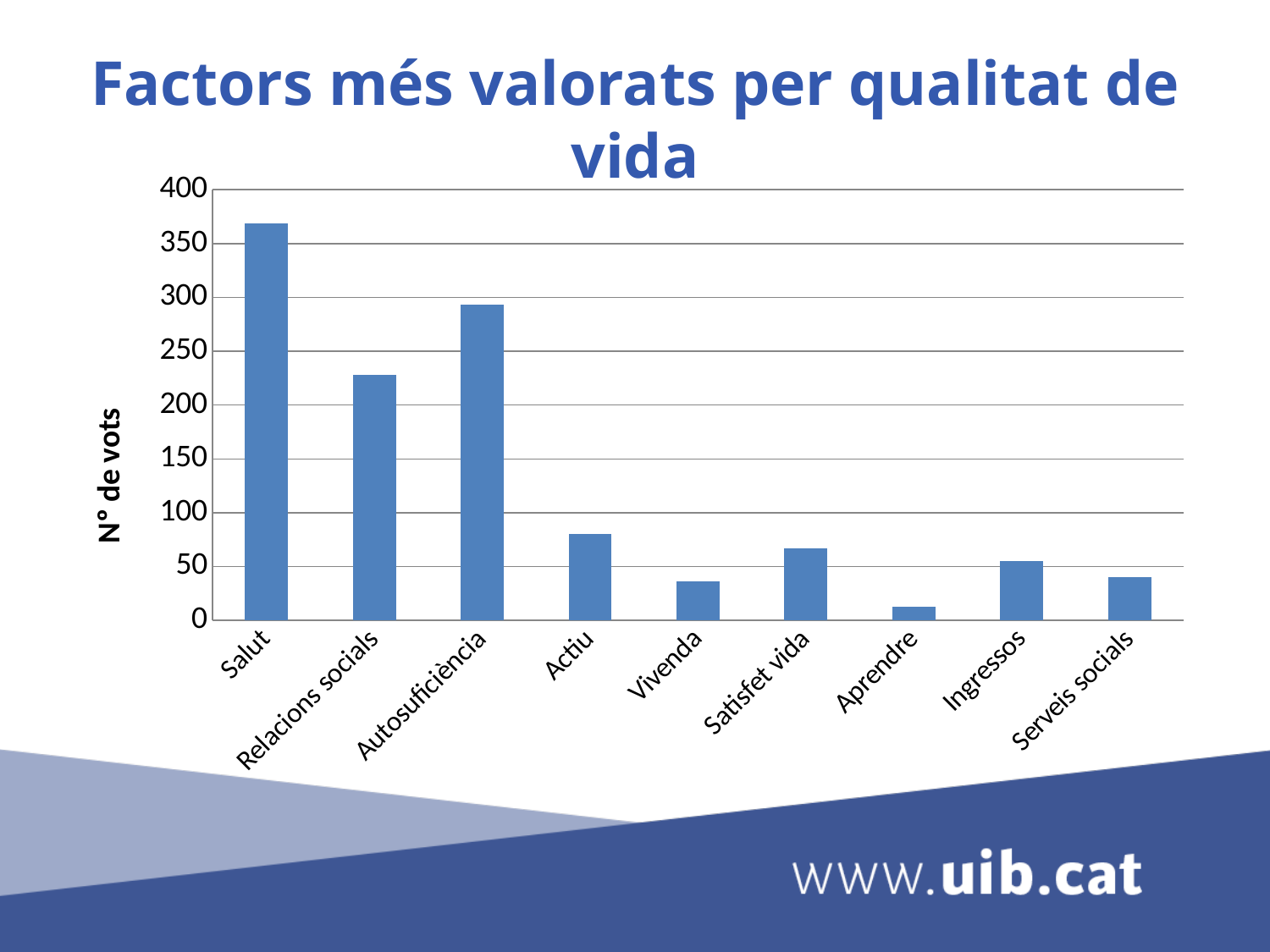
Which category has the highest number of votes? Salut Which category has the lowest number of votes? Aprendre Is the value for Relacions socials greater or less than 250? less Is the value for Autosuficiència greater or less than 250? greater Is the value for Actiu greater or less than 100? less What is the label of the vertical axis of the chart? Nº de vots What kind of chart is shown on the slide? bar chart Which has more votes, Relacions socials or Autosuficiència? Autosuficiència How many categories are shown on the x axis of the chart? 9 Which has more votes, Actiu or Satisfet vida? Actiu